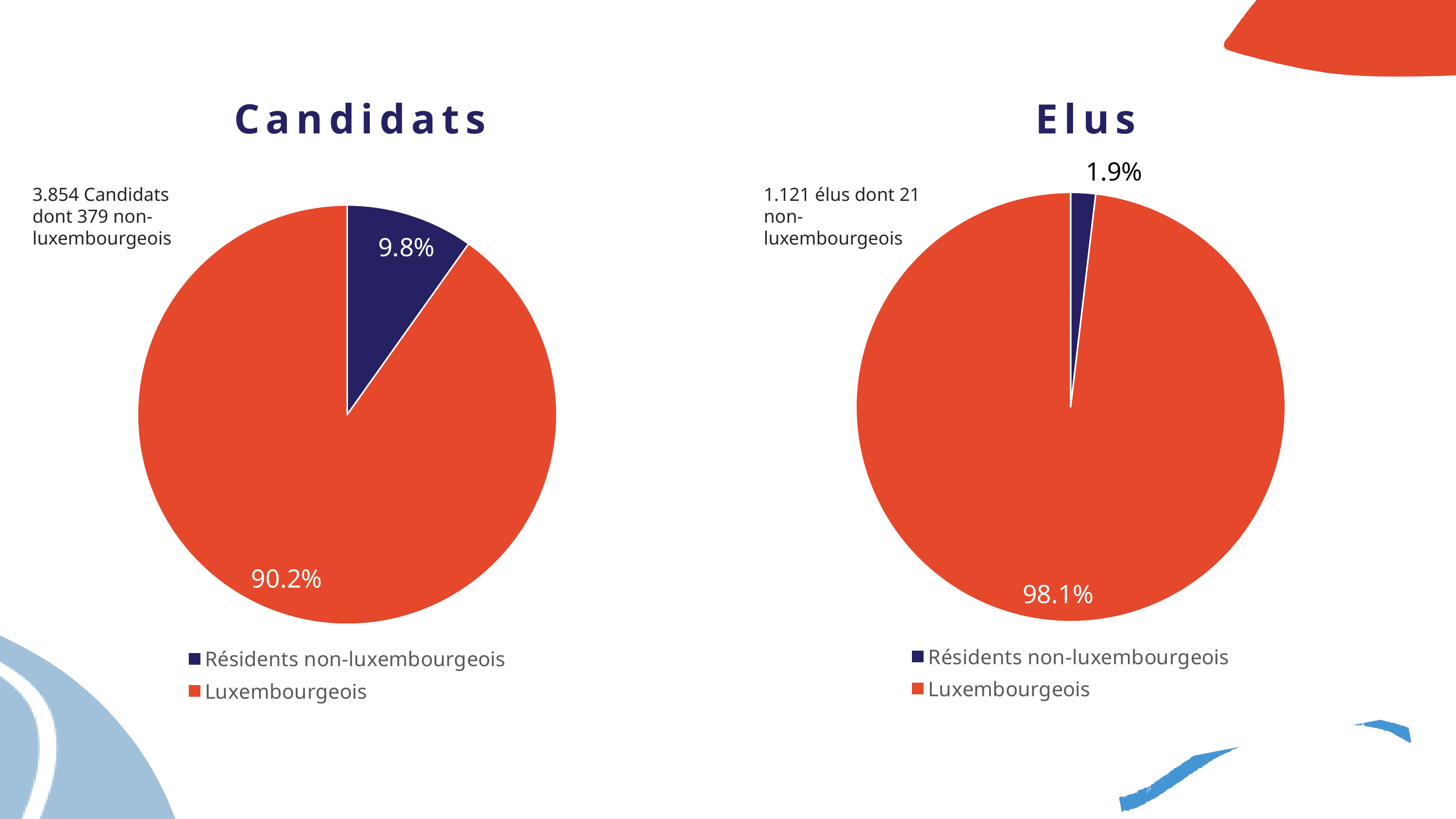
What kind of chart is the 'Candidats' chart? Pie chart In the 'Candidats' chart, what share of the pie is 'Luxembourgeois'? 90.2% In the 'Elus' chart, what share of the pie is 'Luxembourgeois'? 98.1% In the 'Candidats' chart, which slice is the smallest? Résidents non-luxembourgeois How many slices does the 'Elus' pie chart have? 2 In the 'Candidats' chart, what share of the pie is 'Résidents non-luxembourgeois'? 9.8% Which is larger: the 'Résidents non-luxembourgeois' share in the 'Candidats' chart or in the 'Elus' chart? Candidats In the 'Elus' chart, which slice is the largest? Luxembourgeois What is the difference between the 'Luxembourgeois' share in the 'Elus' chart and in the 'Candidats' chart? 7.9% How many entries does the legend of the 'Candidats' chart list? 2 What colour is the 'Luxembourgeois' slice in the 'Elus' chart? Orange-red